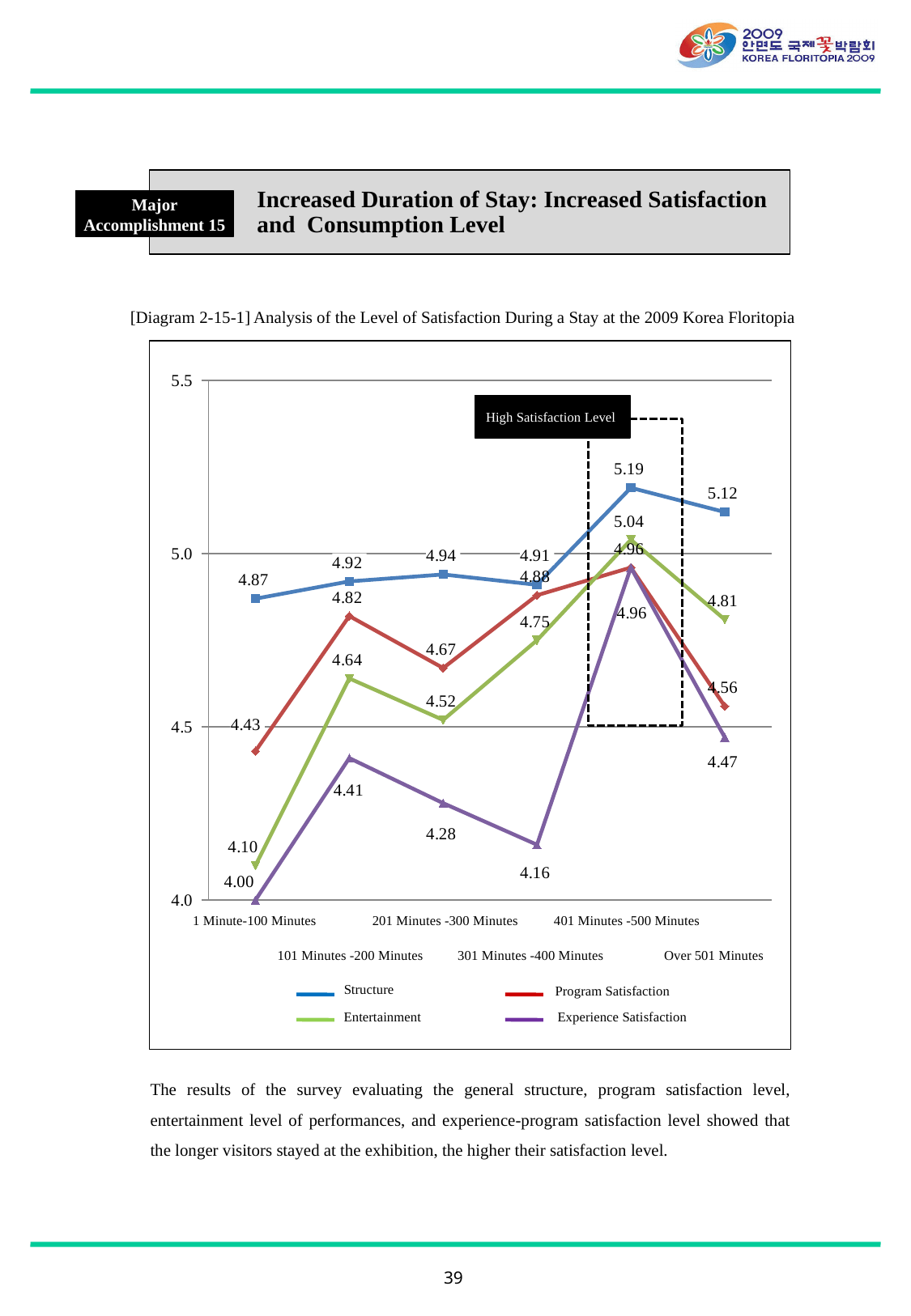
What is the Experience Satisfaction value for 1 Minute-100 Minutes? 4.00 For Over 501 Minutes, which is larger: Entertainment or Program Satisfaction? Entertainment Is the Experience Satisfaction value for 301 Minutes -400 Minutes greater or less than 4.5? less How many duration-of-stay categories are shown on the x axis? 6 What kind of chart is shown in Diagram 2-15-1? line chart What is the Entertainment value for 401 Minutes -500 Minutes? 5.04 In which duration category is the Structure series highest? 401 Minutes -500 Minutes In which duration category is the Entertainment series lowest? 1 Minute-100 Minutes What is the difference between the Structure values for 401 Minutes -500 Minutes and Over 501 Minutes? 0.07 What text appears in the black box above the dashed rectangle? High Satisfaction Level What is the Structure value for 401 Minutes -500 Minutes? 5.19 How many series does the legend list? 4